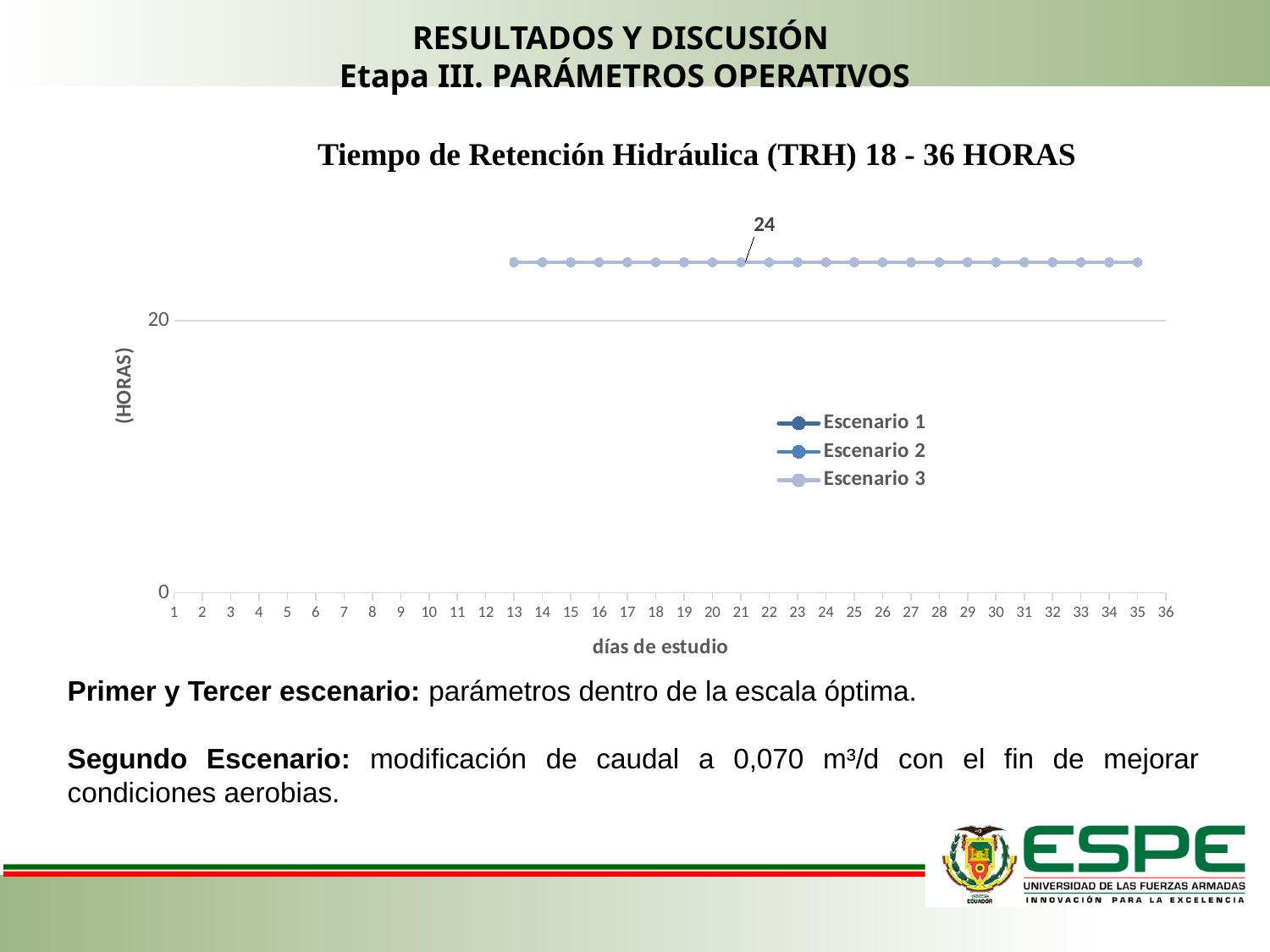
Is the plotted value at day 30 greater or less than 20? greater What kind of chart is shown on the slide? line chart Is the plotted value at day 21 greater or less than 20? greater What value is printed as the data label on the plotted line at day 21? 24 What is the x-axis title of the chart? días de estudio How many series does the chart legend list? 3 What is the title of the chart? Tiempo de Retención Hidráulica (TRH) 18 - 36 HORAS How many days are labelled along the x axis? 36 Does the plotted line rise, fall or stay flat between day 13 and day 35? stays flat